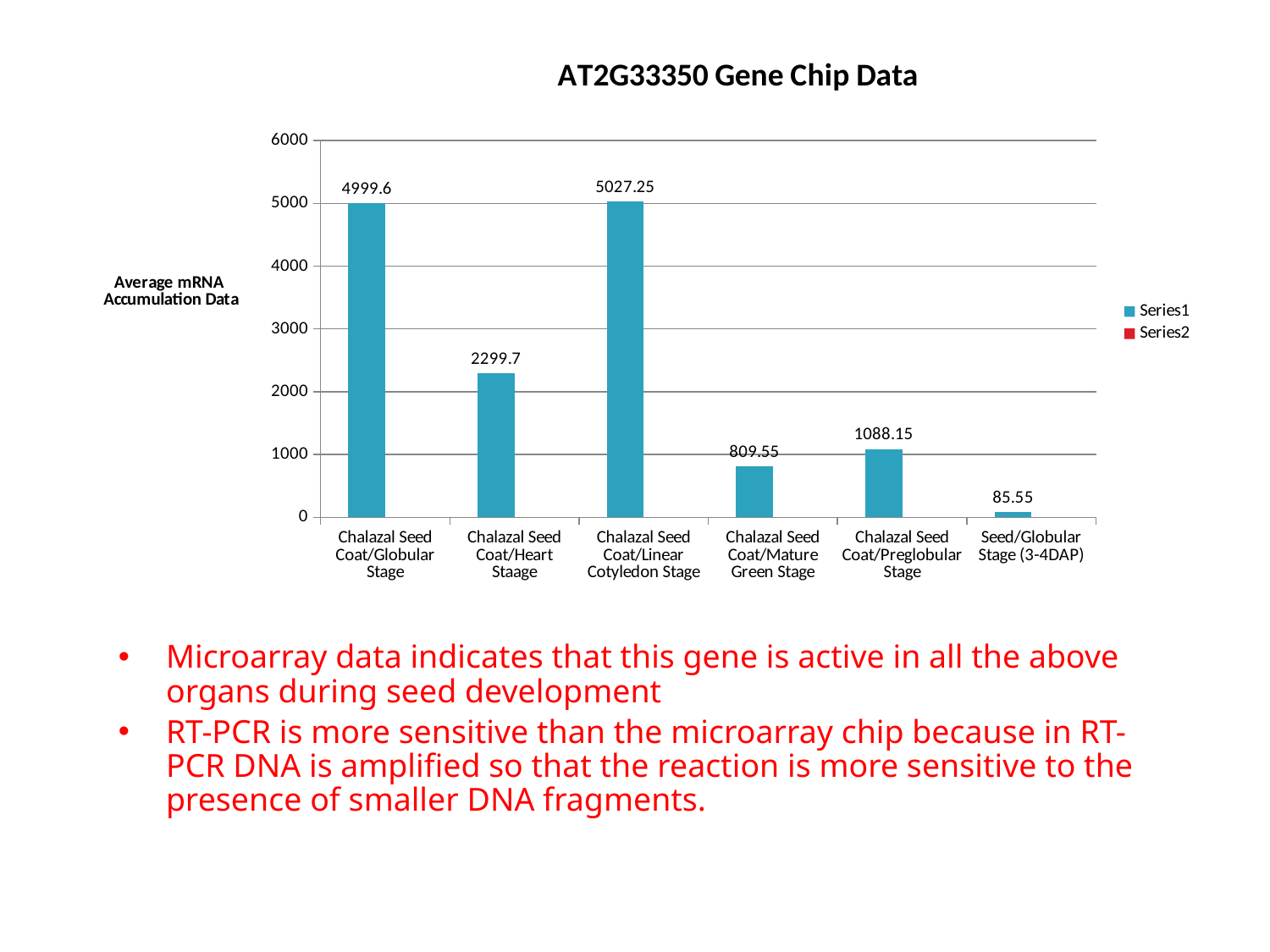
What is the difference between the values for Chalazal Seed Coat/Preglobular Stage and Chalazal Seed Coat/Mature Green Stage? 278.6 Which category has the lowest value? Seed/Globular Stage (3-4DAP) What is the value for Chalazal Seed Coat/Globular Stage? 4999.6 How many categories are shown on the x axis? 6 How many series does the legend list? 2 What is the difference between the values for Chalazal Seed Coat/Linear Cotyledon Stage and Chalazal Seed Coat/Globular Stage? 27.65 What is the value for Chalazal Seed Coat/Mature Green Stage? 809.55 Is the value for Chalazal Seed Coat/Heart Staage greater or less than 2000? greater Which is larger, the value for Chalazal Seed Coat/Heart Staage or the value for Chalazal Seed Coat/Preglobular Stage? Chalazal Seed Coat/Heart Staage What kind of chart is shown on the slide? bar chart What is the value for Seed/Globular Stage (3-4DAP)? 85.55 Which category has the highest value? Chalazal Seed Coat/Linear Cotyledon Stage